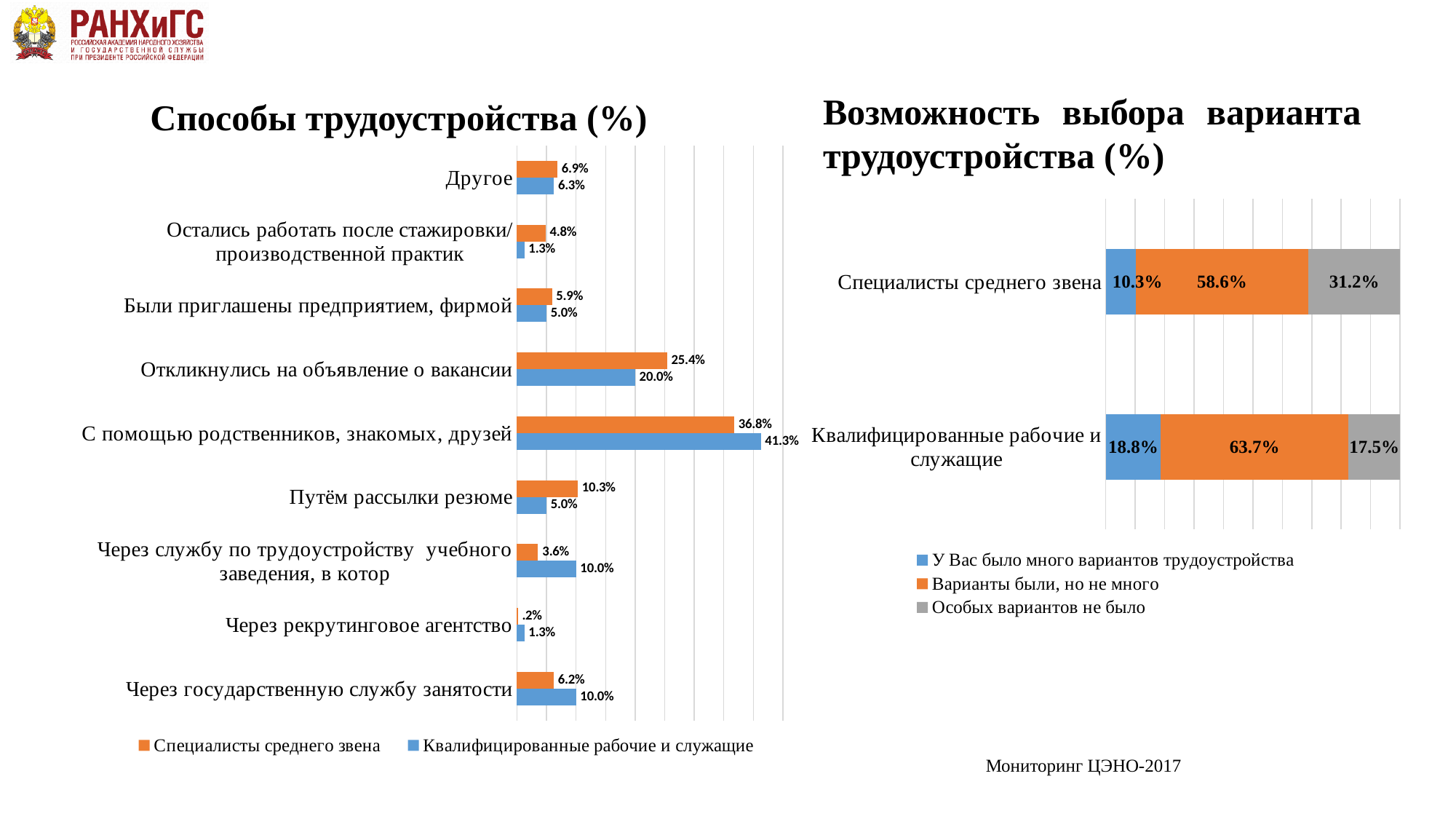
On the chart 'Способы трудоустройства (%)', what is the value for 'Специалисты среднего звена' in the category 'Откликнулись на объявление о вакансии'? 25.4% How many series does the legend of the chart 'Возможность выбора варианта трудоустройства (%)' list? 3 On the chart 'Способы трудоустройства (%)', in the category 'Через государственную службу занятости', which series has the larger value? Квалифицированные рабочие и служащие On the chart 'Возможность выбора варианта трудоустройства (%)', what is the value of 'Варианты были, но не много' for 'Квалифицированные рабочие и служащие'? 63.7% On the chart 'Способы трудоустройства (%)', which category has the highest value for 'Специалисты среднего звена'? С помощью родственников, знакомых, друзей How many series does the legend of the chart 'Способы трудоустройства (%)' list? 2 On the chart 'Способы трудоустройства (%)', what is the difference between the two series in the category 'Путём рассылки резюме'? 5.3% On the chart 'Способы трудоустройства (%)', what is the value for 'Квалифицированные рабочие и служащие' in the category 'С помощью родственников, знакомых, друзей'? 41.3% On the chart 'Возможность выбора варианта трудоустройства (%)', what is the value of 'Особых вариантов не было' for 'Специалисты среднего звена'? 31.2% What kind of chart is 'Способы трудоустройства (%)'? Bar chart How many categories are shown on the chart 'Способы трудоустройства (%)'? 9 On the chart 'Возможность выбора варианта трудоустройства (%)', what is the total of the stacked bar for 'Специалисты среднего звена'? 100.1%